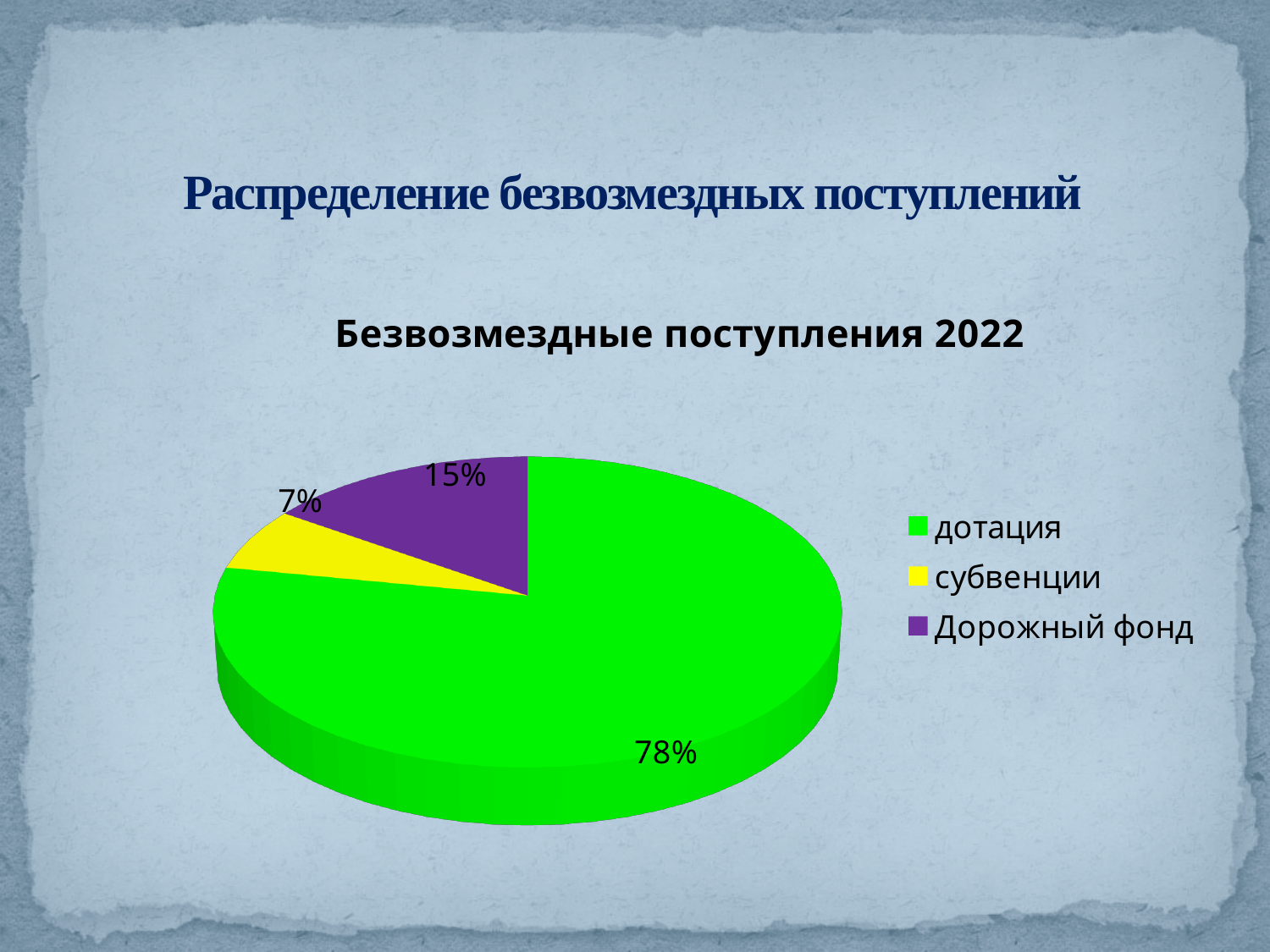
What is the difference in percentage points between дотация and Дорожный фонд? 63 What is the chart's title? Безвозмездные поступления 2022 How many slices does the pie chart have? 3 Which category has the smallest share of the pie? субвенции What share of the pie does дотация have? 78% What colour is the slice for Дорожный фонд? purple What share of the pie does субвенции have? 7% How many entries does the legend list? 3 What share of the pie does Дорожный фонд have? 15% Which is larger, the share for Дорожный фонд or the share for субвенции? Дорожный фонд Which category has the largest share of the pie? дотация What type of chart is shown on the slide? pie chart